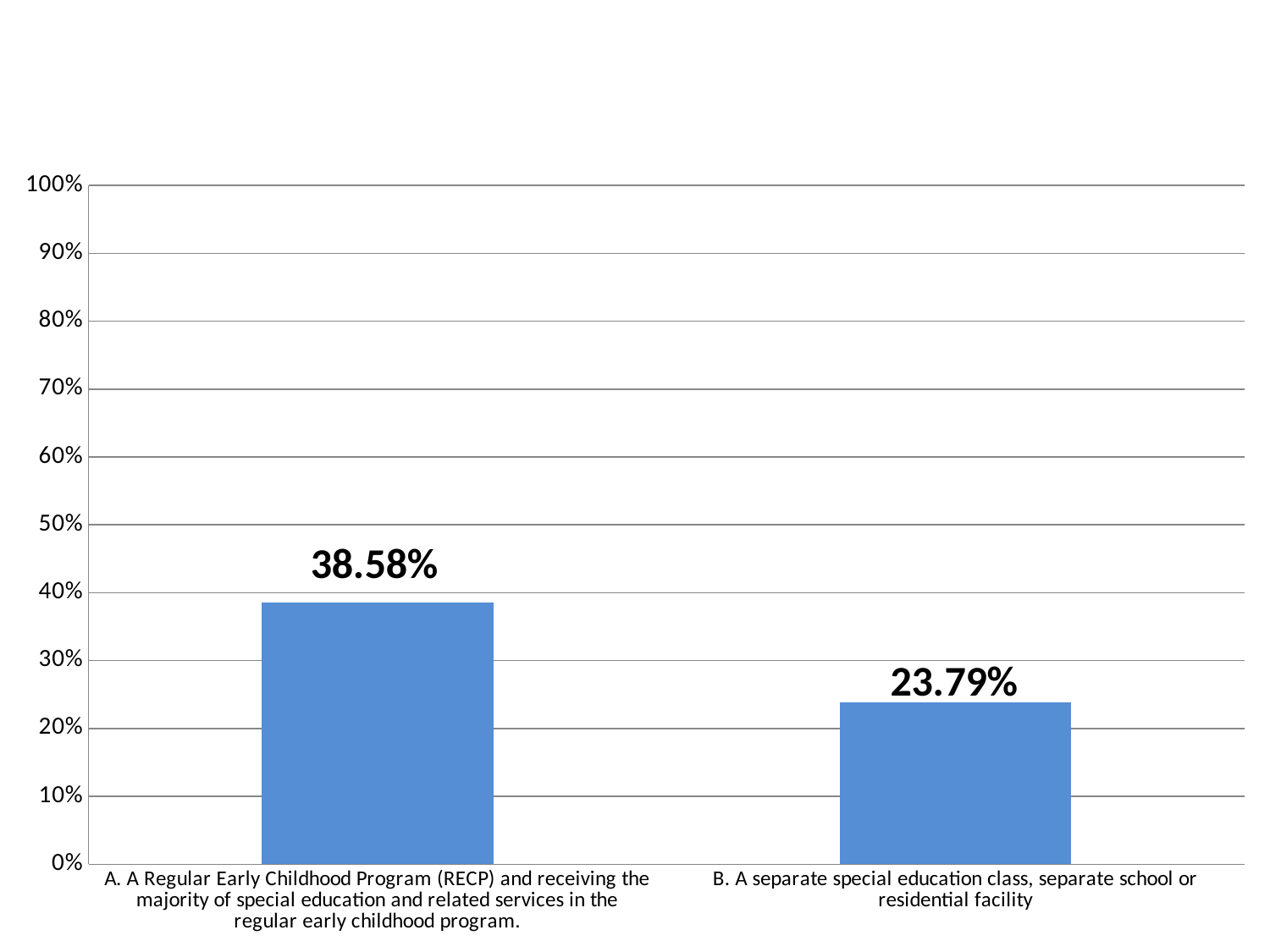
Is the value for category A greater or less than 30%? greater Which is larger, the value for category A or the value for category B? Category A What colour are the bars in the chart? Blue What is the value for category B (A separate special education class, separate school or residential facility)? 23.79% Is the value for category B greater or less than 30%? less How many categories are shown in the chart? 2 What kind of chart is shown on the slide? Bar chart What is the maximum value shown on the vertical axis? 100% Which category has the highest value? A. A Regular Early Childhood Program (RECP) and receiving the majority of special education and related services in the regular early childhood program. What is the value for category A (A Regular Early Childhood Program (RECP) and receiving the majority of special education and related services in the regular early childhood program)? 38.58% What is the difference between the values for category A and category B? 14.79% Which category has the lowest value? B. A separate special education class, separate school or residential facility